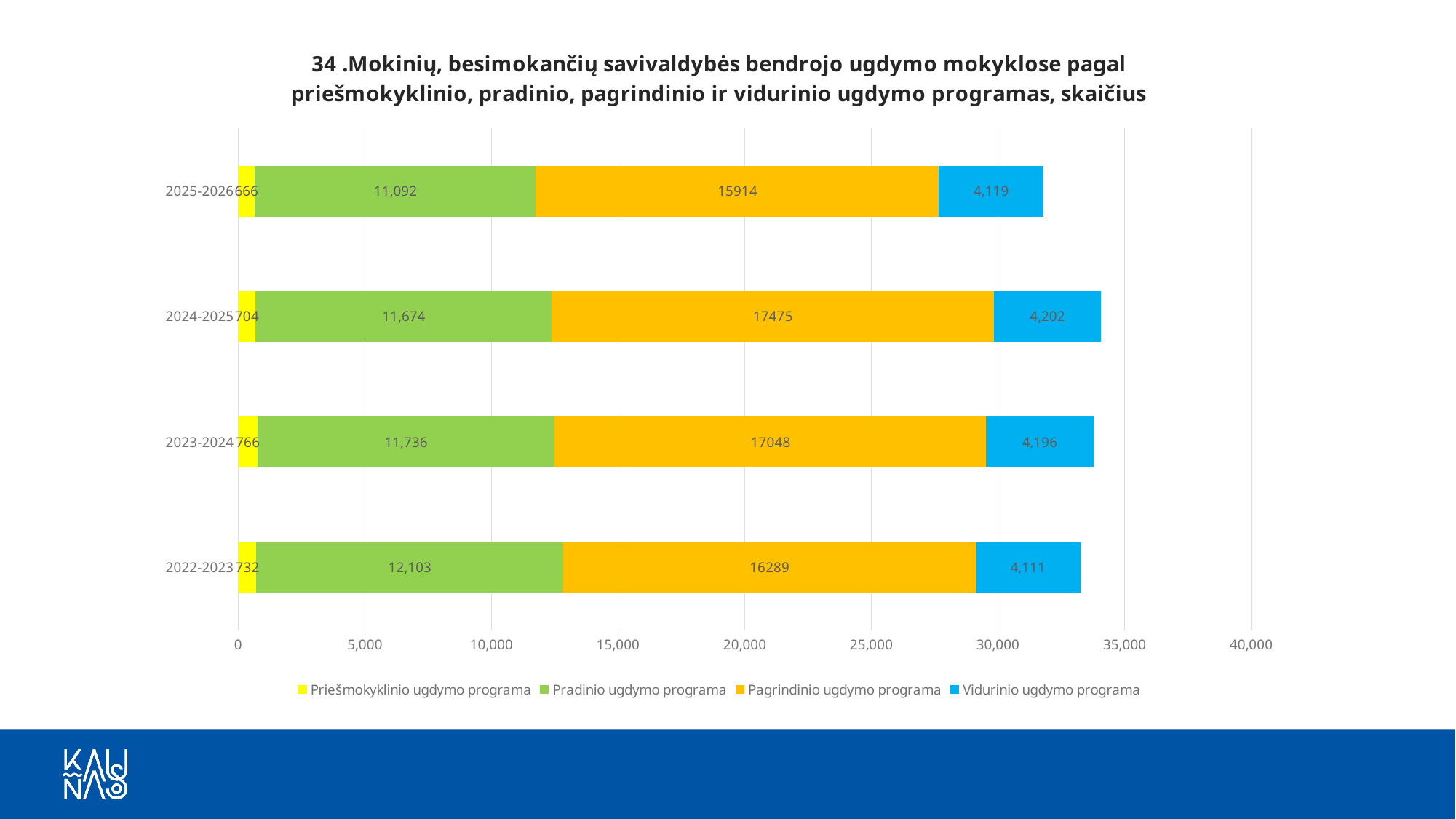
How many series does the legend list? 4 What is the total number of pupils across all four programmes in 2025-2026? 31,791 What is the value for Pagrindinio ugdymo programa in 2024-2025? 17475 In which school year is the value for Pradinio ugdymo programa the lowest? 2025-2026 In which school year is the value for Pagrindinio ugdymo programa the highest? 2024-2025 How many school years (categories) are shown on the chart? 4 What is the value for Priešmokyklinio ugdymo programa in 2025-2026? 666 Does the value for Pradinio ugdymo programa rise or fall from 2022-2023 to 2025-2026? Fall What is the value for Vidurinio ugdymo programa in 2023-2024? 4,196 What is the difference between the Pagrindinio ugdymo programa values for 2024-2025 and 2025-2026? 1561 What is the value for Pradinio ugdymo programa in 2022-2023? 12,103 What type of chart is shown on the slide? Stacked horizontal bar chart